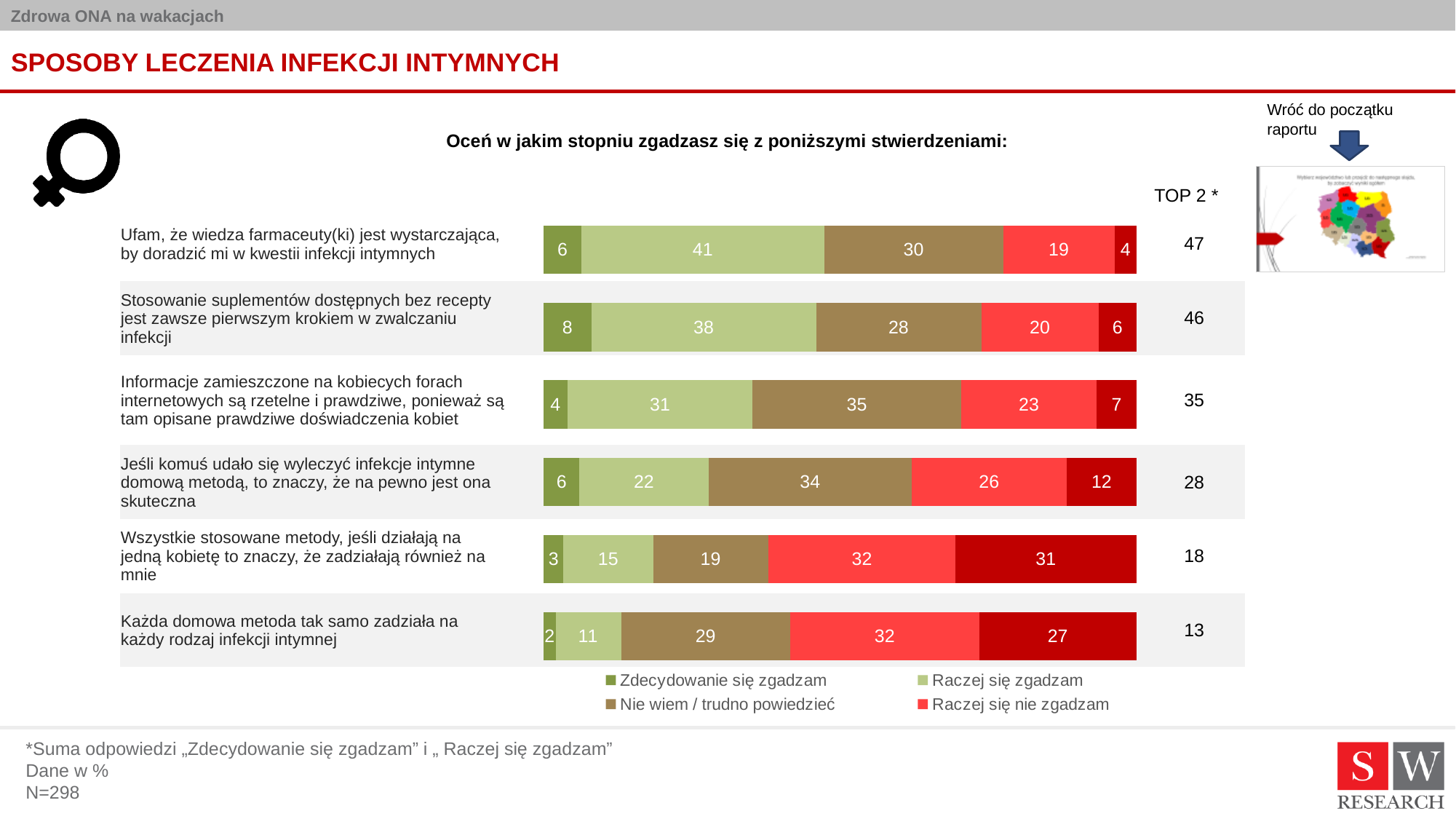
How many series does the chart's legend list? 4 Which colour represents 'Nie wiem / trudno powiedzieć' in the chart? Brown What is the TOP 2 value for the statement 'Stosowanie suplementów dostępnych bez recepty jest zawsze pierwszym krokiem w zwalczaniu infekcji'? 46 What is the 'Raczej się zgadzam' value for the statement 'Ufam, że wiedza farmaceuty(ki) jest wystarczająca, by doradzić mi w kwestii infekcji intymnych'? 41 What is the difference between the 'Raczej się nie zgadzam' values for 'Wszystkie stosowane metody, jeśli działają na jedną kobietę...' and 'Jeśli komuś udało się wyleczyć infekcje intymne domową metodą...'? 6 Which statement has the highest TOP 2 value? Ufam, że wiedza farmaceuty(ki) jest wystarczająca, by doradzić mi w kwestii infekcji intymnych Which statement has the lowest TOP 2 value? Każda domowa metoda tak samo zadziała na każdy rodzaj infekcji intymnej What kind of chart is shown on the slide? Stacked bar chart How many statements (categories) are plotted in the chart? 6 What is the total of the 'Zdecydowanie się zgadzam' and 'Raczej się zgadzam' segments for the statement 'Jeśli komuś udało się wyleczyć infekcje intymne domową metodą, to znaczy, że na pewno jest ona skuteczna'? 28 What is the 'Nie wiem / trudno powiedzieć' value for the statement 'Informacje zamieszczone na kobiecych forach internetowych są rzetelne i prawdziwe...'? 35 Which is larger: the 'Zdecydowanie się zgadzam' value for 'Stosowanie suplementów dostępnych bez recepty...' or for 'Każda domowa metoda tak samo zadziała...'? Stosowanie suplementów dostępnych bez recepty...